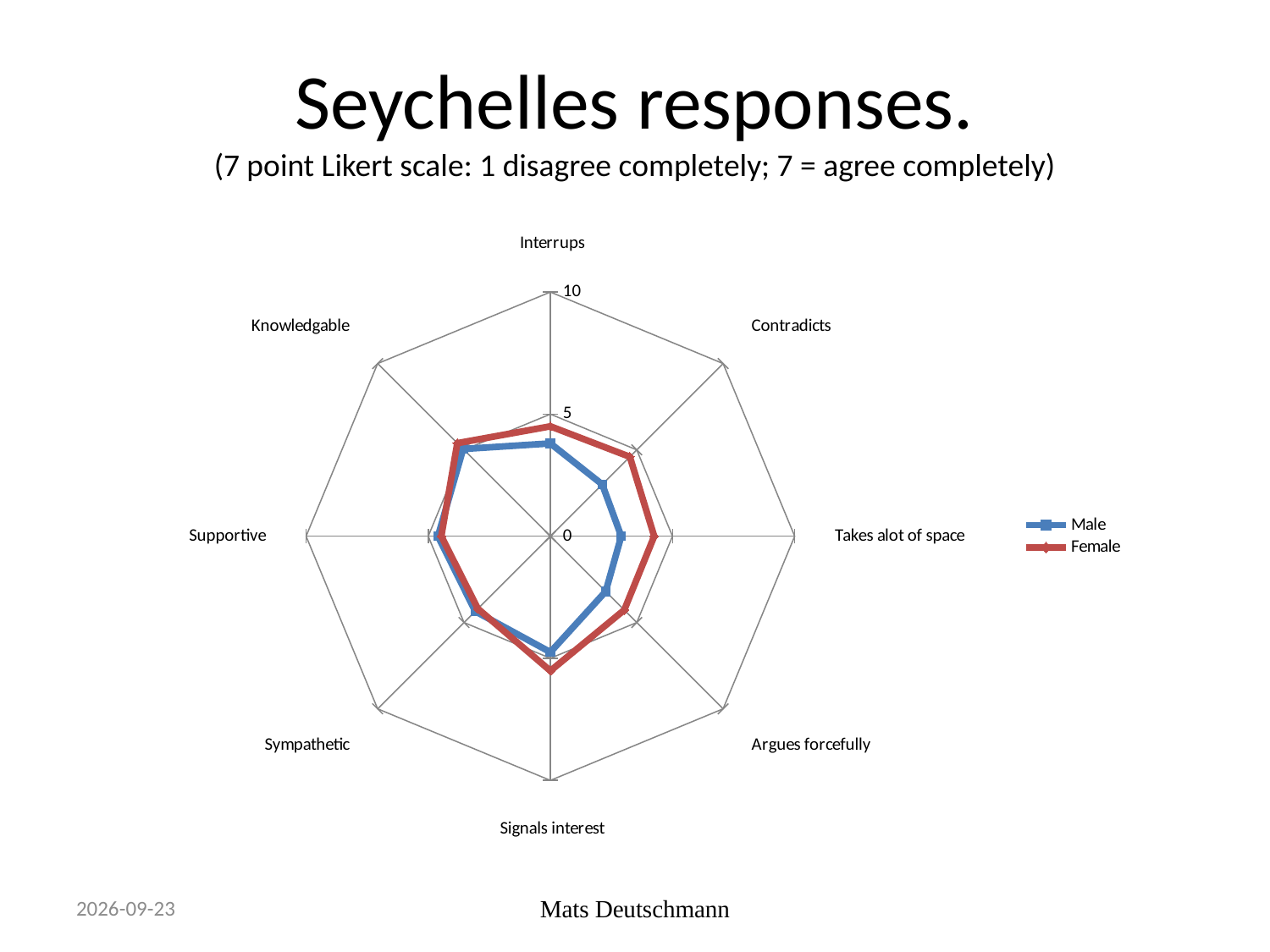
For Argues forcefully, which series has the larger value, Male or Female? Female Is the Female value for Takes alot of space greater or less than 5? less How many categories (axes) does the radar chart have? 8 Is the Male value for Contradicts greater or less than 5? less Which colour represents the Female series in the chart? Red For Takes alot of space, which series has the larger value, Male or Female? Female How many series does the legend list? 2 What kind of chart is shown on the slide? Radar chart Is the Male value for Argues forcefully greater or less than 5? less What is the title of the chart on the slide? Seychelles responses. For Contradicts, which series has the larger value, Male or Female? Female